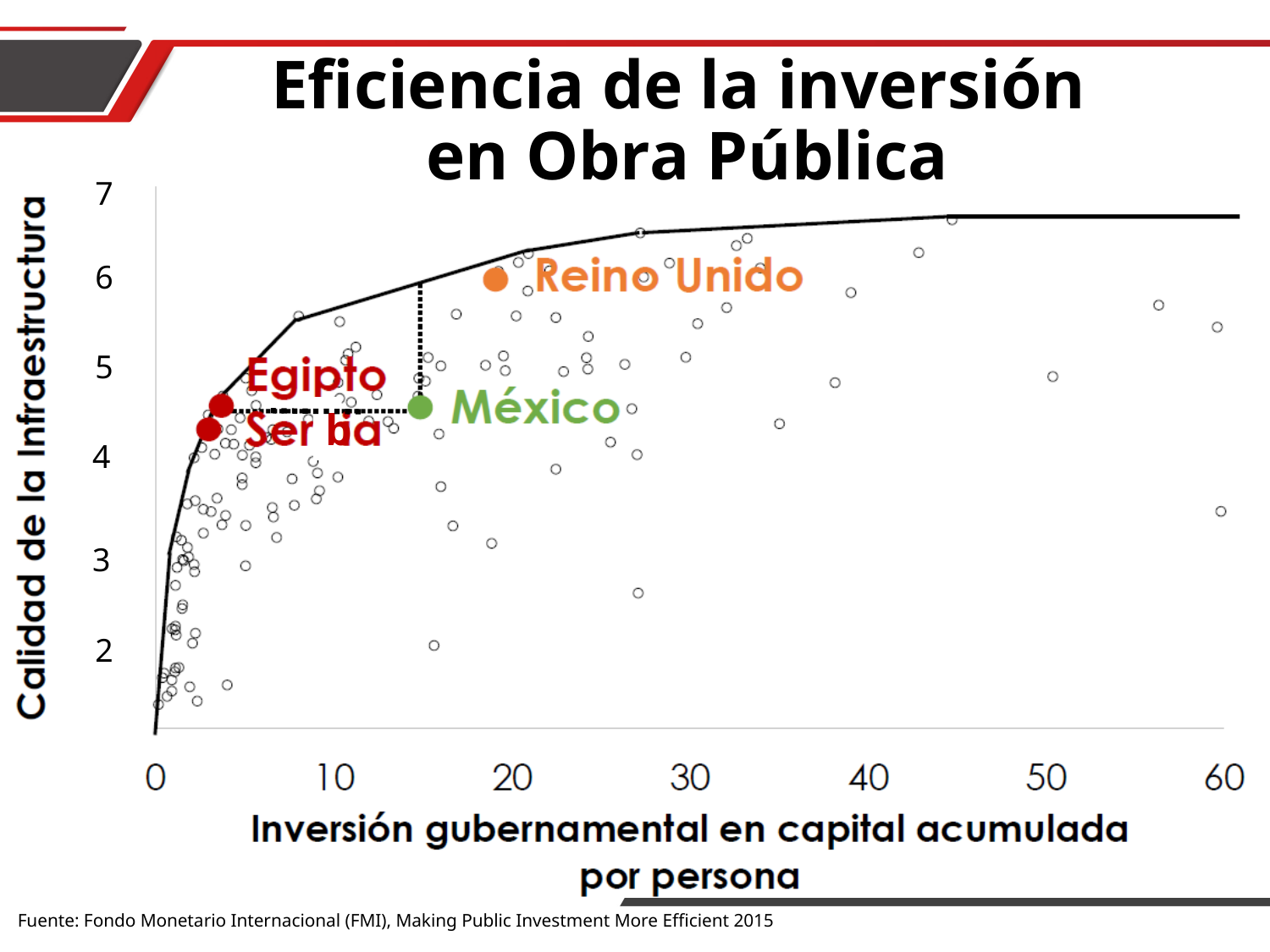
Is the 'Calidad de la Infraestructura' value for Reino Unido greater or less than 5? greater Is the value of 'Inversión gubernamental en capital acumulada por persona' for Egipto greater or less than 10? less What is the title of the slide's chart? Eficiencia de la inversión en Obra Pública Is the 'Calidad de la Infraestructura' value for México greater or less than 5? less How many countries are labeled by name on the chart? 4 Which has a higher 'Inversión gubernamental en capital acumulada por persona' value, Reino Unido or México? Reino Unido What kind of chart is shown on the slide? scatter plot Which has a higher 'Calidad de la Infraestructura' value, Reino Unido or México? Reino Unido What is the label of the y axis? Calidad de la Infraestructura